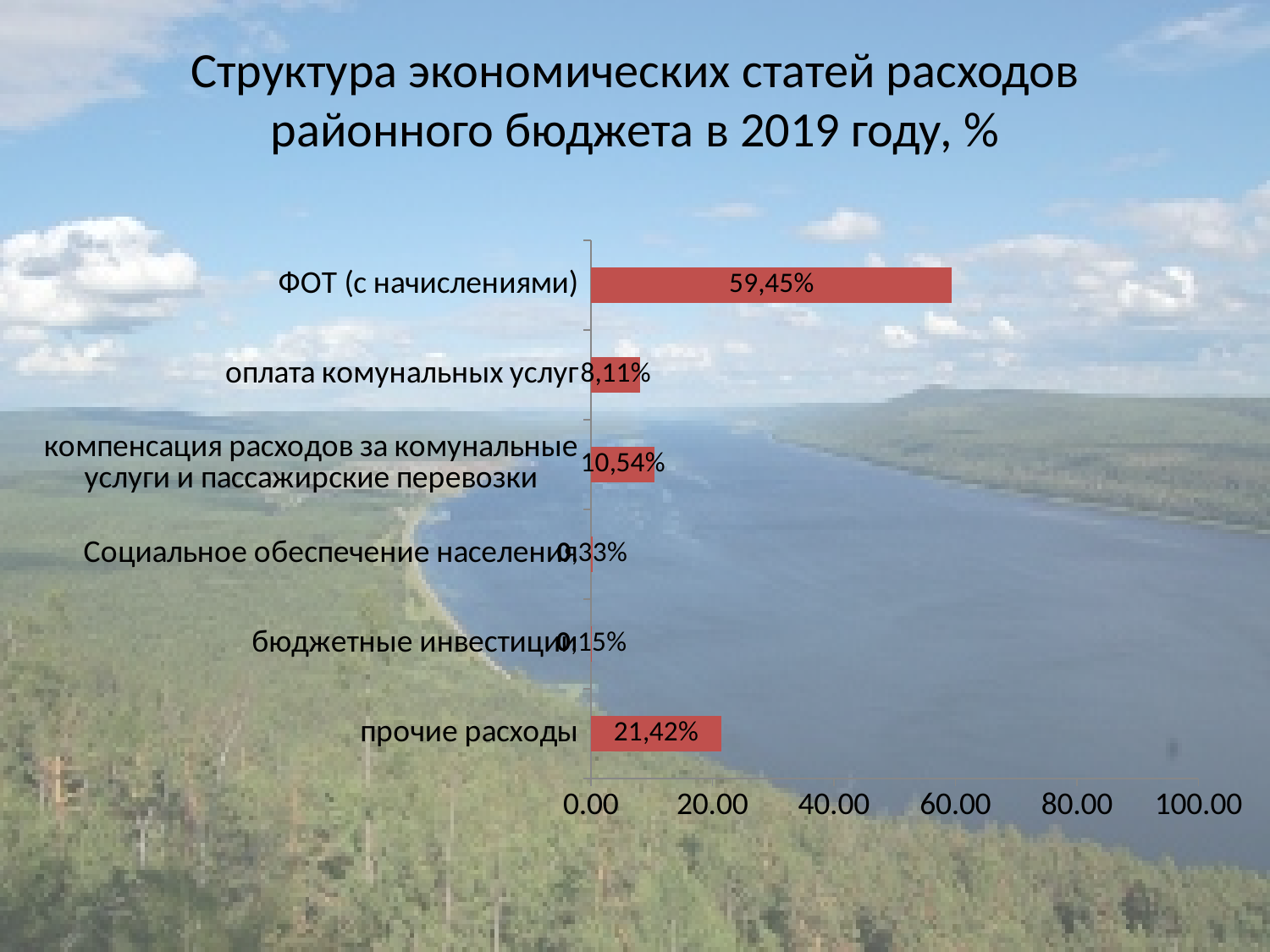
What is the value for ФОТ (с начислениями)? 59,45% Which is larger: компенсация расходов за коммунальные услуги и пассажирские перевозки or оплата коммунальных услуг? компенсация расходов за коммунальные услуги и пассажирские перевозки What is the value for прочие расходы? 21,42% How many categories are shown in the chart? 6 What kind of chart is shown on the slide? bar chart Is the value for прочие расходы greater or less than 20.00? greater Which category has the lowest value? бюджетные инвестиции What is the value for бюджетные инвестиции? 0,15% What is the value for оплата коммунальных услуг? 8,11% Which category has the highest value? ФОТ (с начислениями) What is the title of the chart? Структура экономических статей расходов районного бюджета в 2019 году, % What is the difference between the values for ФОТ (с начислениями) and прочие расходы? 38,03%